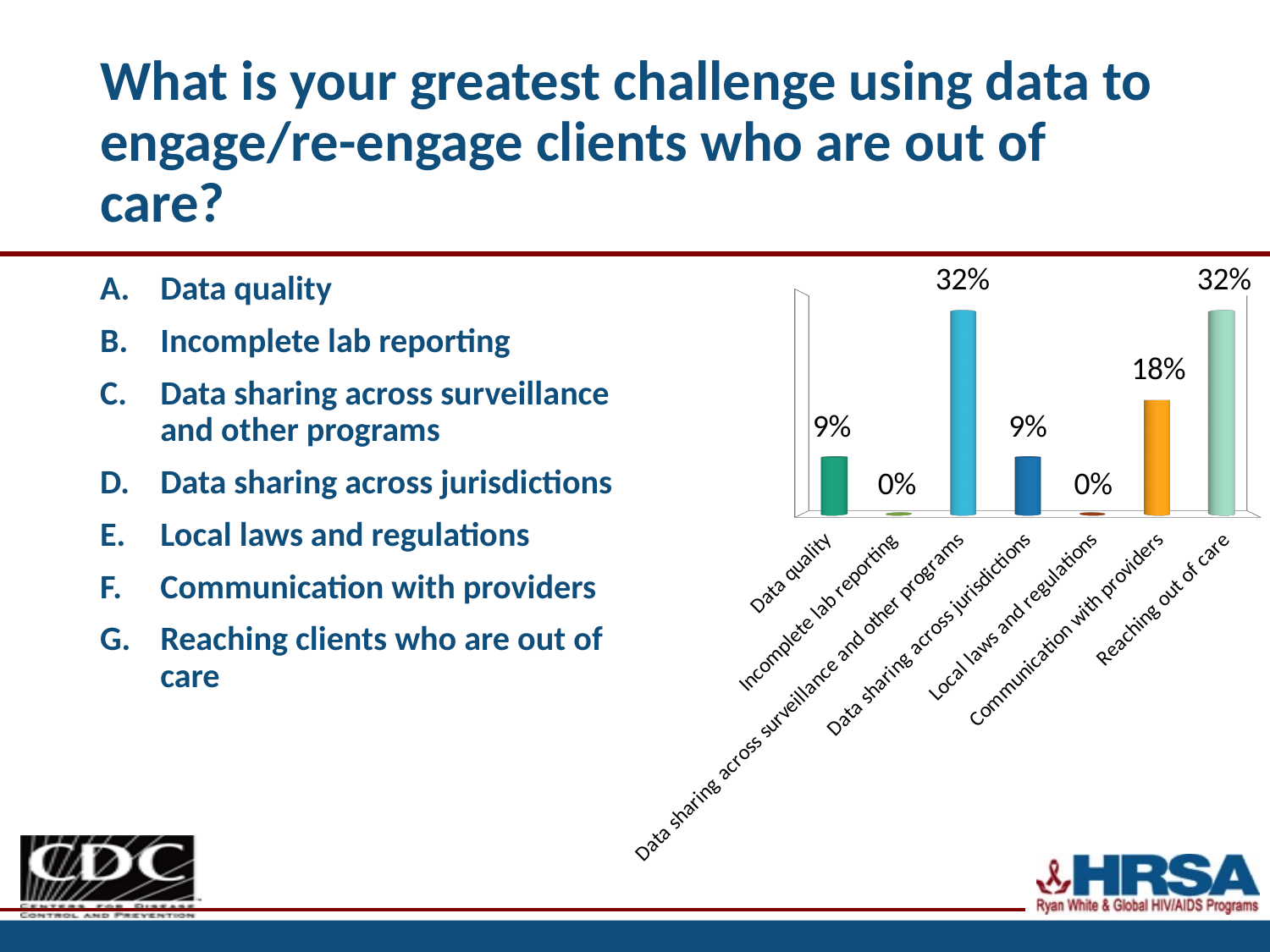
What kind of chart is shown on the slide? bar chart What is the value for Reaching out of care? 32% What is the value for Local laws and regulations? 0% What is the difference between the value for Reaching out of care and the value for Communication with providers? 14% What is the value for Data quality? 9% Which is larger, the value for Communication with providers or the value for Data sharing across jurisdictions? Communication with providers Which two categories share the highest value in the chart? Data sharing across surveillance and other programs and Reaching out of care What is the value for Data sharing across surveillance and other programs? 32% What is the value for Incomplete lab reporting? 0% What is the difference between the value for Data sharing across surveillance and other programs and the value for Data quality? 23% What is the value for Communication with providers? 18% How many categories are plotted in the chart? 7